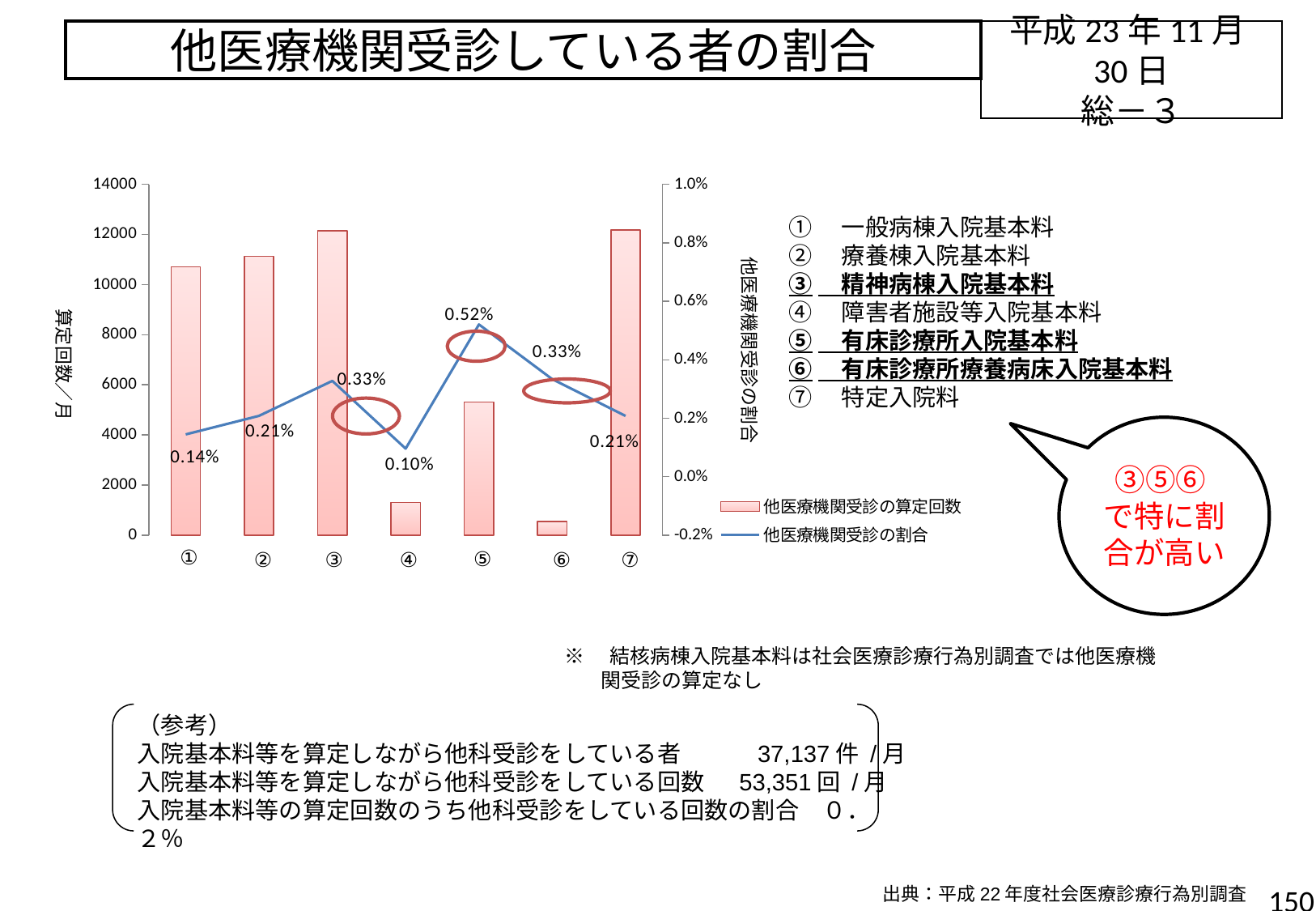
Which category has the highest 他医療機関受診の割合? ⑤ Is the 他医療機関受診の算定回数 bar for category ④ greater or less than 2000? less What is the 他医療機関受診の割合 value for category ⑤? 0.52% What kind of chart is shown on the slide? Combination bar and line chart What is the 他医療機関受診の割合 value for category ①? 0.14% How many series does the chart legend list? 2 What is the difference between the 他医療機関受診の割合 for ⑤ and for ④? 0.42% What is the 他医療機関受診の割合 value for category ④? 0.10% How many categories are shown on the x axis of the chart? 7 Which category has the lowest 他医療機関受診の割合? ④ Which has a higher 他医療機関受診の割合, category ③ or category ②? ③